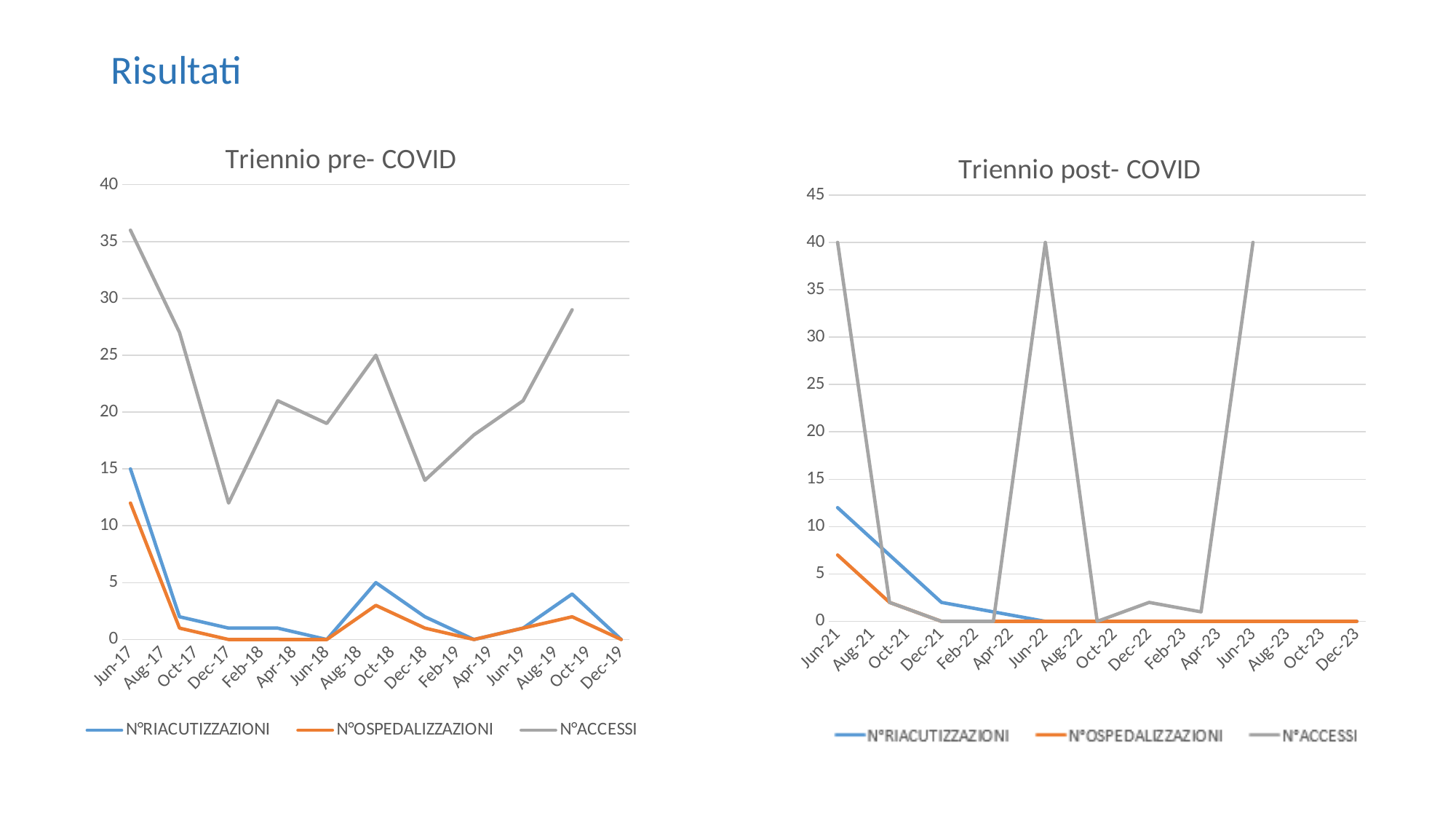
What kind of chart is the 'Triennio pre- COVID' chart? line chart In the 'Triennio pre- COVID' chart, which series has the highest value at Jun-17? N°ACCESSI In the 'Triennio post- COVID' chart, is the value of N°RIACUTIZZAZIONI at Jun-21 greater or less than 10? greater In the 'Triennio post- COVID' chart, what is the value of N°ACCESSI at Jun-22? 40 How many series does the legend of the 'Triennio post- COVID' chart list? 3 What is the highest value shown on the y axis of the 'Triennio post- COVID' chart? 45 How many date labels are shown on the x axis of the 'Triennio post- COVID' chart? 16 In the 'Triennio pre- COVID' chart, what is the value of N°RIACUTIZZAZIONI at Jun-17? 15 In the 'Triennio post- COVID' chart, at Jun-21 which is larger, N°RIACUTIZZAZIONI or N°OSPEDALIZZAZIONI? N°RIACUTIZZAZIONI In the 'Triennio pre- COVID' chart, is the value of N°ACCESSI at Jun-17 greater or less than 30? greater In the 'Triennio post- COVID' chart, what is the value of N°ACCESSI at Jun-21? 40 In the 'Triennio post- COVID' chart, does N°RIACUTIZZAZIONI rise or fall from Jun-21 to Jun-22? fall